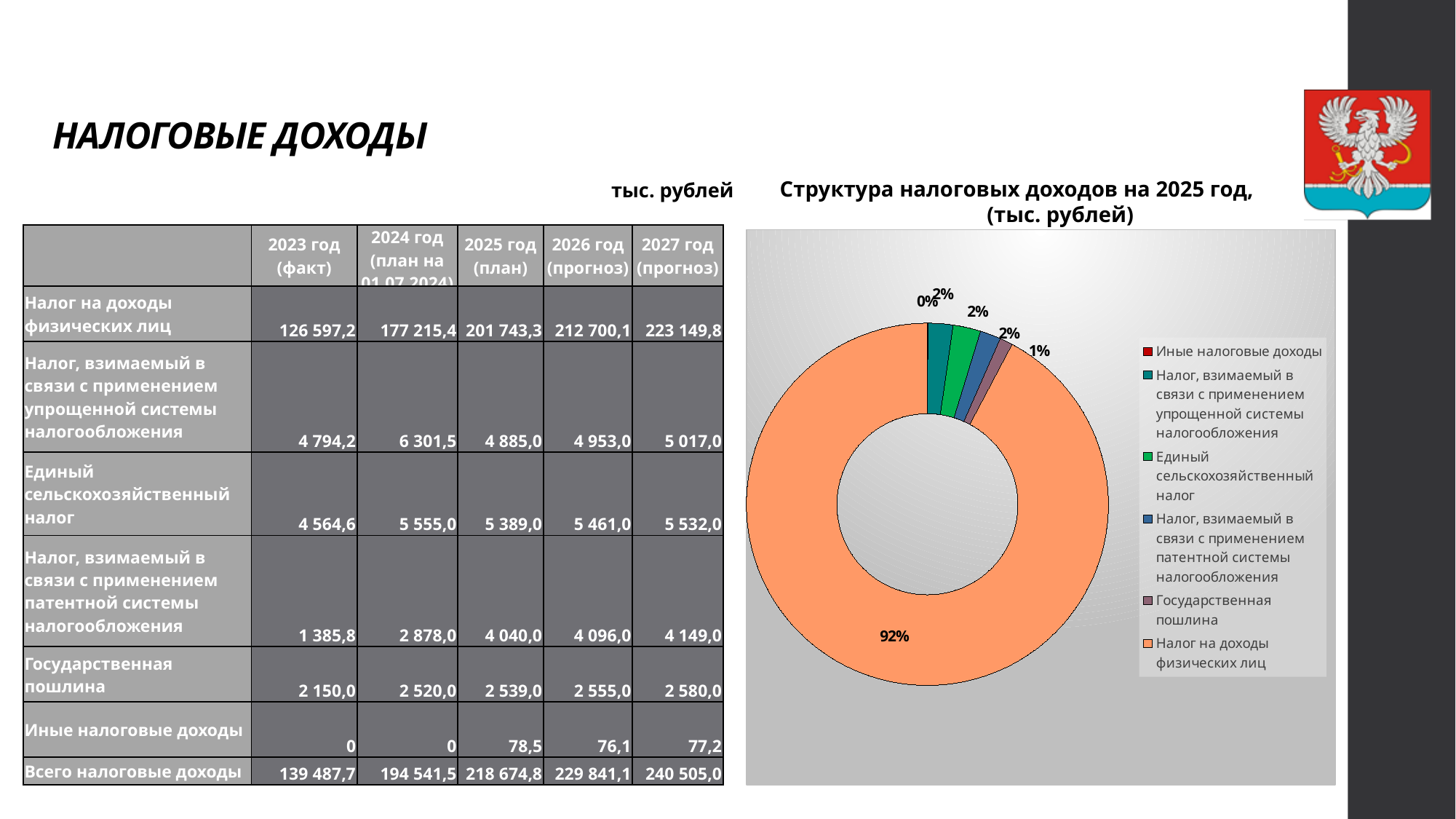
In the pie chart, what share is shown for Единый сельскохозяйственный налог? 2% How many entries does the legend of the pie chart list? 6 In the pie chart, what share is shown for Государственная пошлина? 1% Which category has the smallest slice in the pie chart? Иные налоговые доходы What kind of chart is shown on the right of the slide? Pie (doughnut) chart What colour is the slice for Налог на доходы физических лиц in the pie chart? Orange In the pie chart, what is the difference in percentage points between the share for Налог на доходы физических лиц and the share for Государственная пошлина? 91 percentage points In the pie chart, what share is shown for Налог на доходы физических лиц? 92% What is the title of the chart on the right? Структура налоговых доходов на 2025 год, (тыс. рублей) In the pie chart, which is larger: the slice for Налог на доходы физических лиц or the slice for Государственная пошлина? Налог на доходы физических лиц Which category has the largest slice in the pie chart? Налог на доходы физических лиц